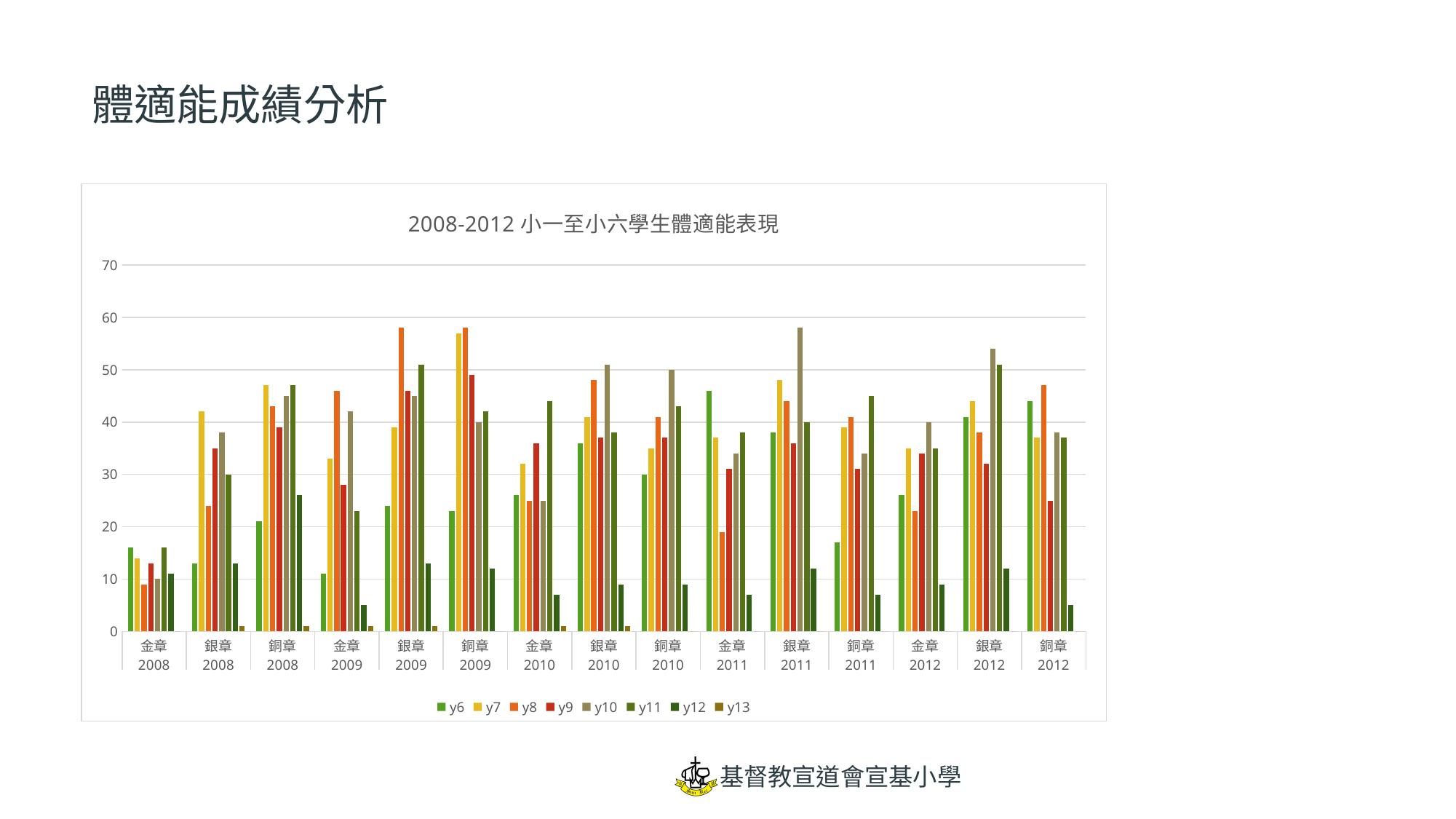
What is the title of the chart? 2008-2012 小一至小六學生體適能表現 Which series has the lowest value in the 銀章 2009 category? y13 Is the value for y12 in 金章 2009 greater or less than 10? less Which is larger: the value for y6 in 金章 2011 or the value for y6 in 金章 2008? 金章 2011 Which series has the highest value in the 金章 2011 category? y6 What kind of chart is shown on the slide? bar chart Is the value for y6 in 金章 2008 greater or less than 20? less How many series does the legend list? 8 Which series has the highest value in the 銀章 2011 category? y10 How many categories are shown along the x axis? 15 Is the value for y10 in 銀章 2012 greater or less than 50? greater